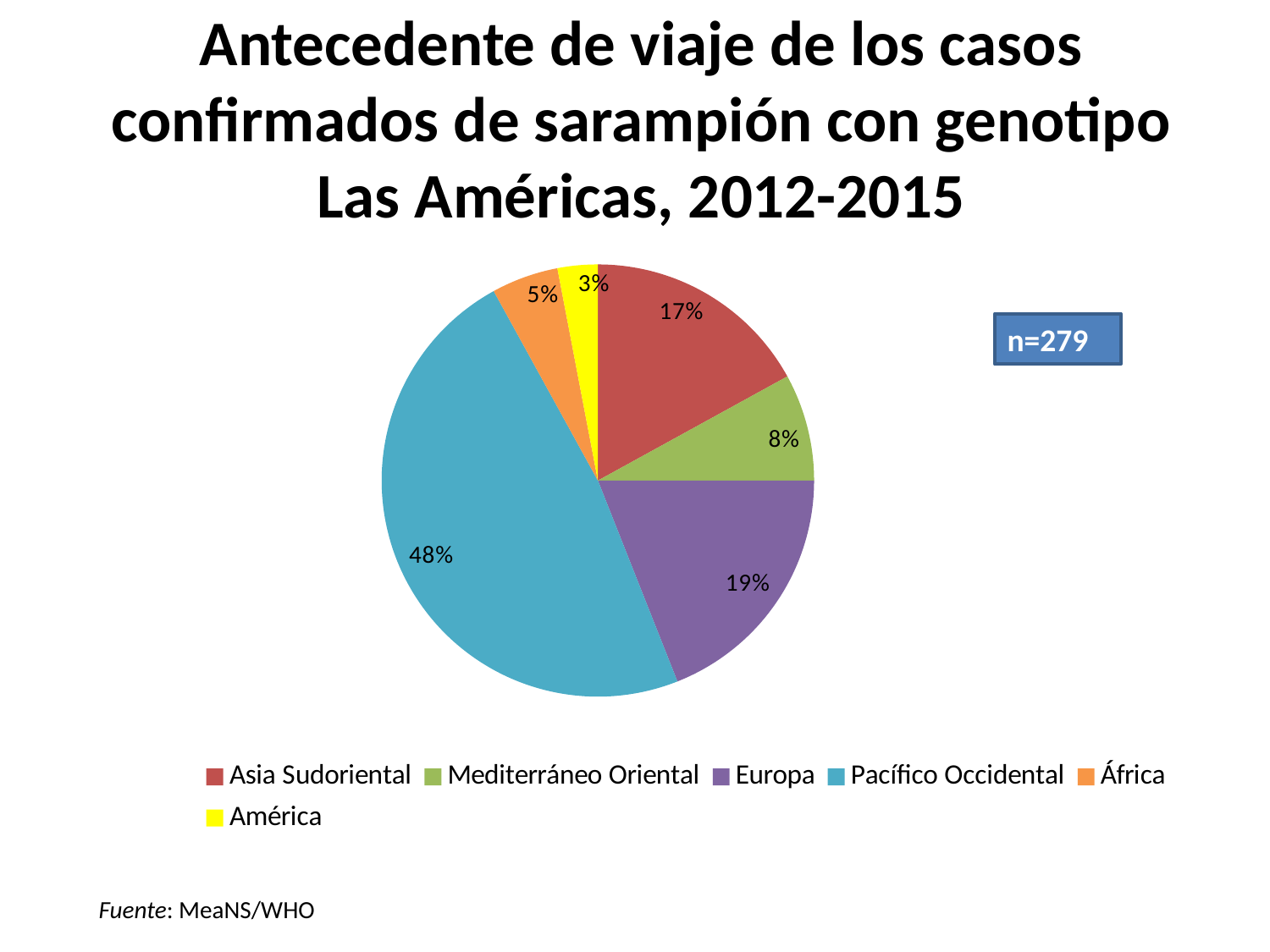
Which region has the largest slice of the pie? Pacífico Occidental What is the value shown for Asia Sudoriental? 17% What share of the pie does Pacífico Occidental account for? 48% What kind of chart is shown on the slide? Pie chart What is the total number of cases (n) indicated on the slide? 279 What is the difference in percentage points between Europa and Asia Sudoriental? 2 What is the value shown for África? 5% Which is larger, the share for Mediterráneo Oriental or the share for África? Mediterráneo Oriental Which region has the smallest slice of the pie? América What is the value shown for Europa? 19% How many regions are shown in the pie chart? 6 What is the value shown for Mediterráneo Oriental? 8%